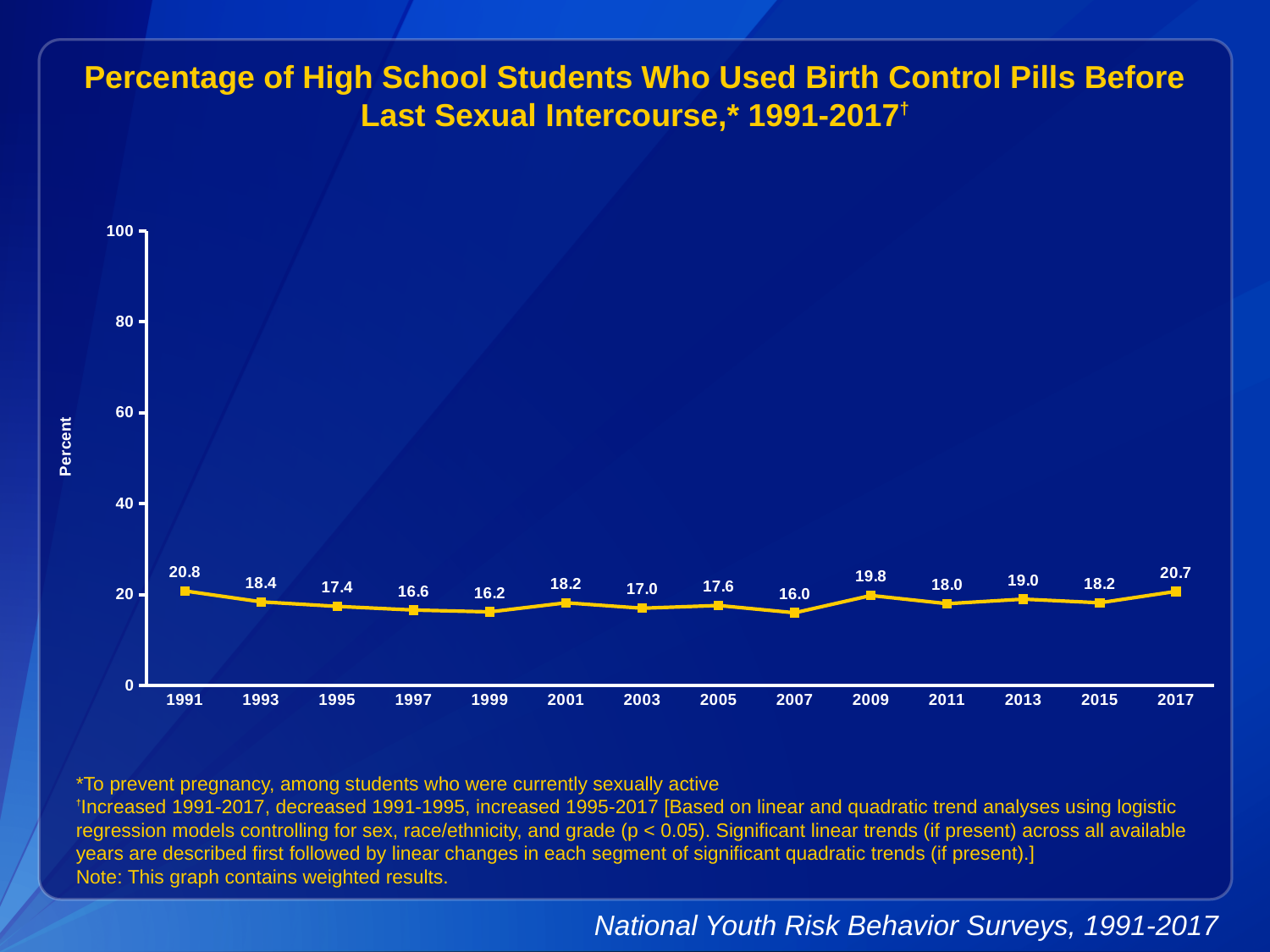
What percentage of high school students used birth control pills before last sexual intercourse in 1991? 20.8 What is the difference between the values for 2017 and 2007? 4.7 What is the label on the y axis? Percent What kind of chart is shown on the slide? line chart Which year has the highest value on the chart? 1991 Is the value for 1999 greater or less than 20? less How many years are plotted on the x axis? 14 Which year has the larger value, 2009 or 2011? 2009 What is the value plotted for 2017? 20.7 Did the value rise or fall from 1991 to 1995? fall Which year has the lowest value on the chart? 2007 What is the value plotted for 2007? 16.0